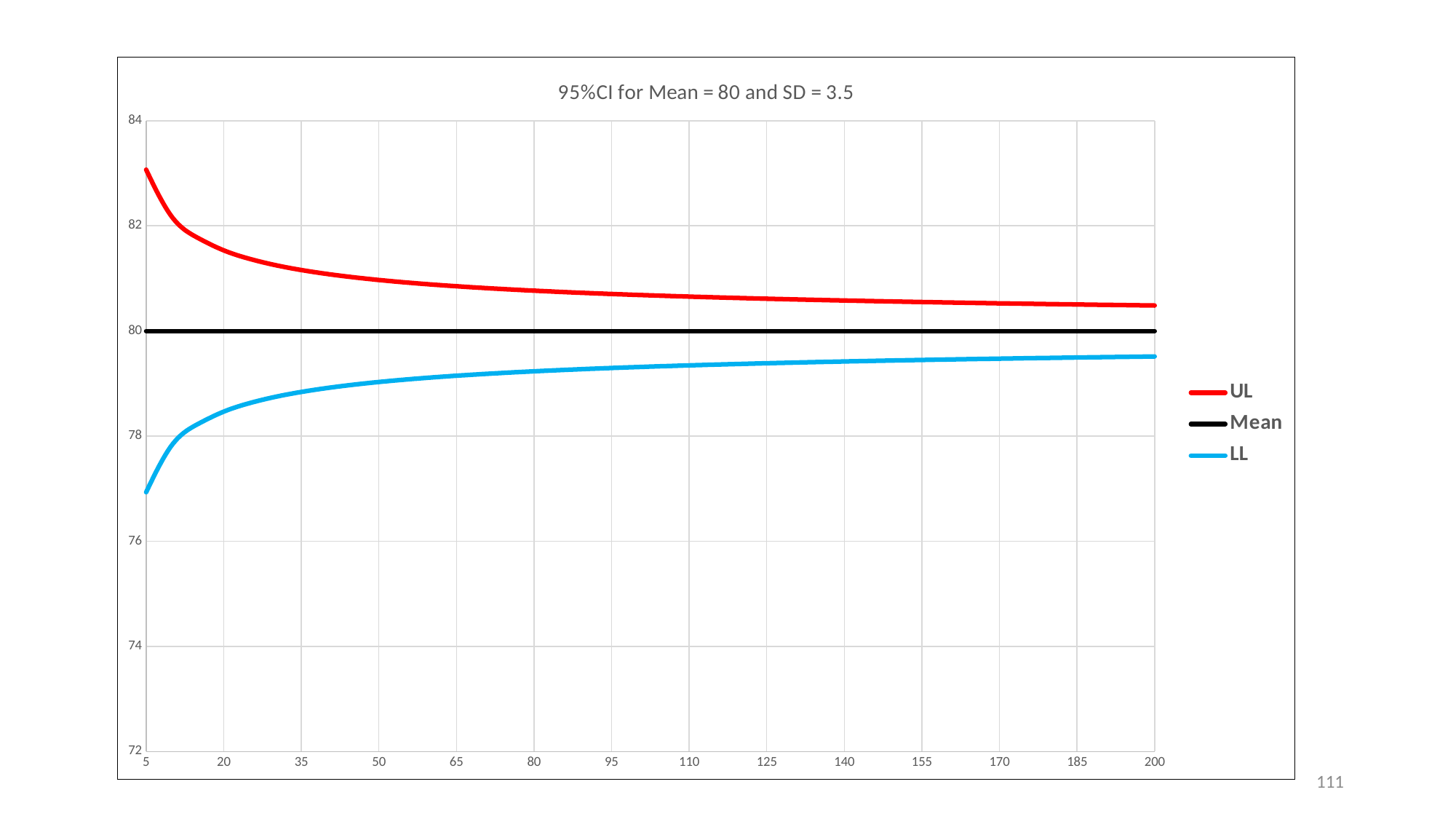
Does the UL line rise or fall as the x axis increases from 5 to 200? fall Which colour is used for the LL series in the legend? blue Is the value of LL at x = 200 greater or less than 78? greater What value does the Mean line sit at across the whole x axis? 80 At x = 50, which is larger, UL or LL? UL Is the value of UL at x = 5 greater or less than 82? greater What is the title of the chart? 95%CI for Mean = 80 and SD = 3.5 Does the LL line rise or fall as the x axis increases from 5 to 200? rise Is the value of UL at x = 200 greater or less than 82? less How many series does the legend list? 3 What kind of chart is shown on the slide? line chart